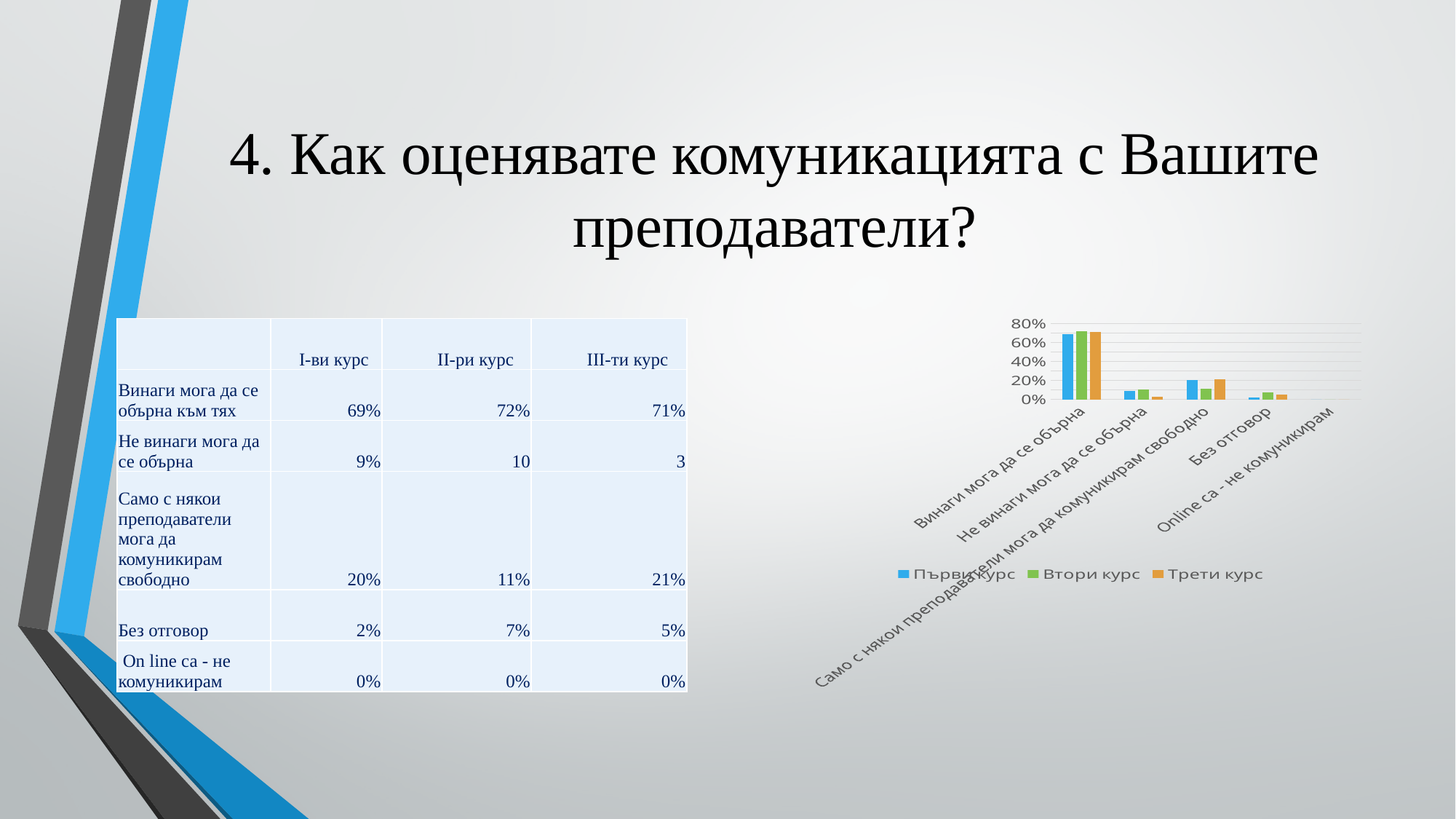
What kind of chart is shown on the slide? bar chart According to the slide, what is the value for II-ри курс for 'Без отговор'? 7% Which category has the highest bars in the chart? Винаги мога да се обърна According to the slide, what is the value for III-ти курс for 'Само с някои преподаватели мога да комуникирам свободно'? 21% What is the name of the series shown in orange in the chart legend? Трети курс How many series does the chart legend list? 3 For 'Само с някои преподаватели мога да комуникирам свободно', which is larger: the I-ви курс value or the II-ри курс value? I-ви курс What is the difference between the II-ри курс and I-ви курс values for 'Винаги мога да се обърна към тях'? 3% Is the value for Първи курс in the category 'Винаги мога да се обърна' greater or less than 60%? greater How many categories are shown on the x axis of the chart? 5 Is the value for Трети курс in the category 'Без отговор' greater or less than 20%? less According to the slide, what is the value for I-ви курс for 'Винаги мога да се обърна към тях'? 69%